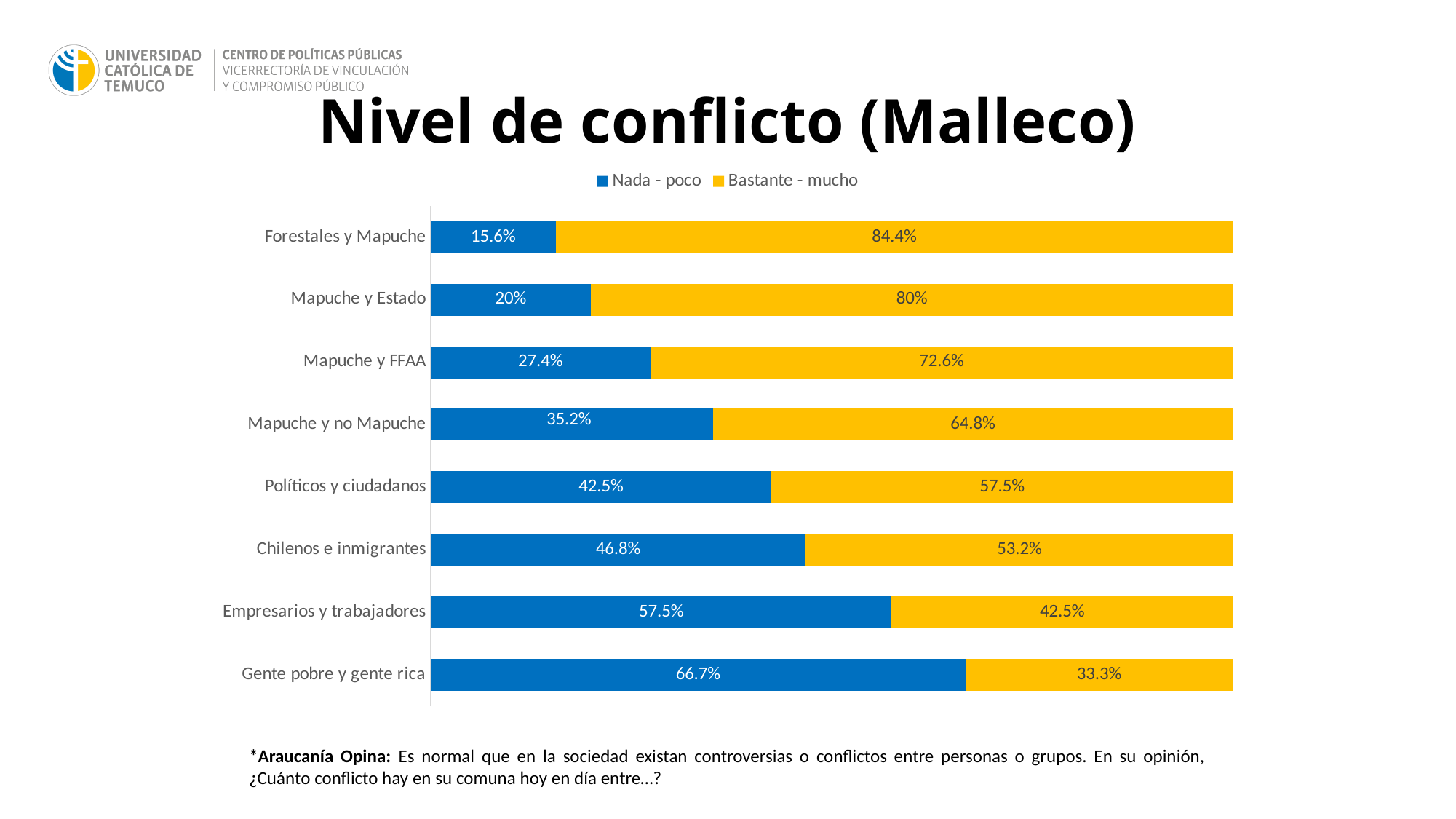
What is the 'Bastante - mucho' value for Forestales y Mapuche? 84.4% Which category has the lowest 'Nada - poco' value? Forestales y Mapuche What is the title of the chart? Nivel de conflicto (Malleco) How many series does the legend list? 2 How many categories are shown on the chart? 8 Which is larger for Políticos y ciudadanos: 'Nada - poco' or 'Bastante - mucho'? Bastante - mucho What is the 'Nada - poco' value for Mapuche y Estado? 20% Which category has the highest 'Bastante - mucho' value? Forestales y Mapuche What is the 'Bastante - mucho' value for Chilenos e inmigrantes? 53.2% What is the 'Nada - poco' value for Gente pobre y gente rica? 66.7% What is the difference between the 'Bastante - mucho' and 'Nada - poco' values for Mapuche y FFAA? 45.2% What kind of chart is shown on the slide? Stacked bar chart